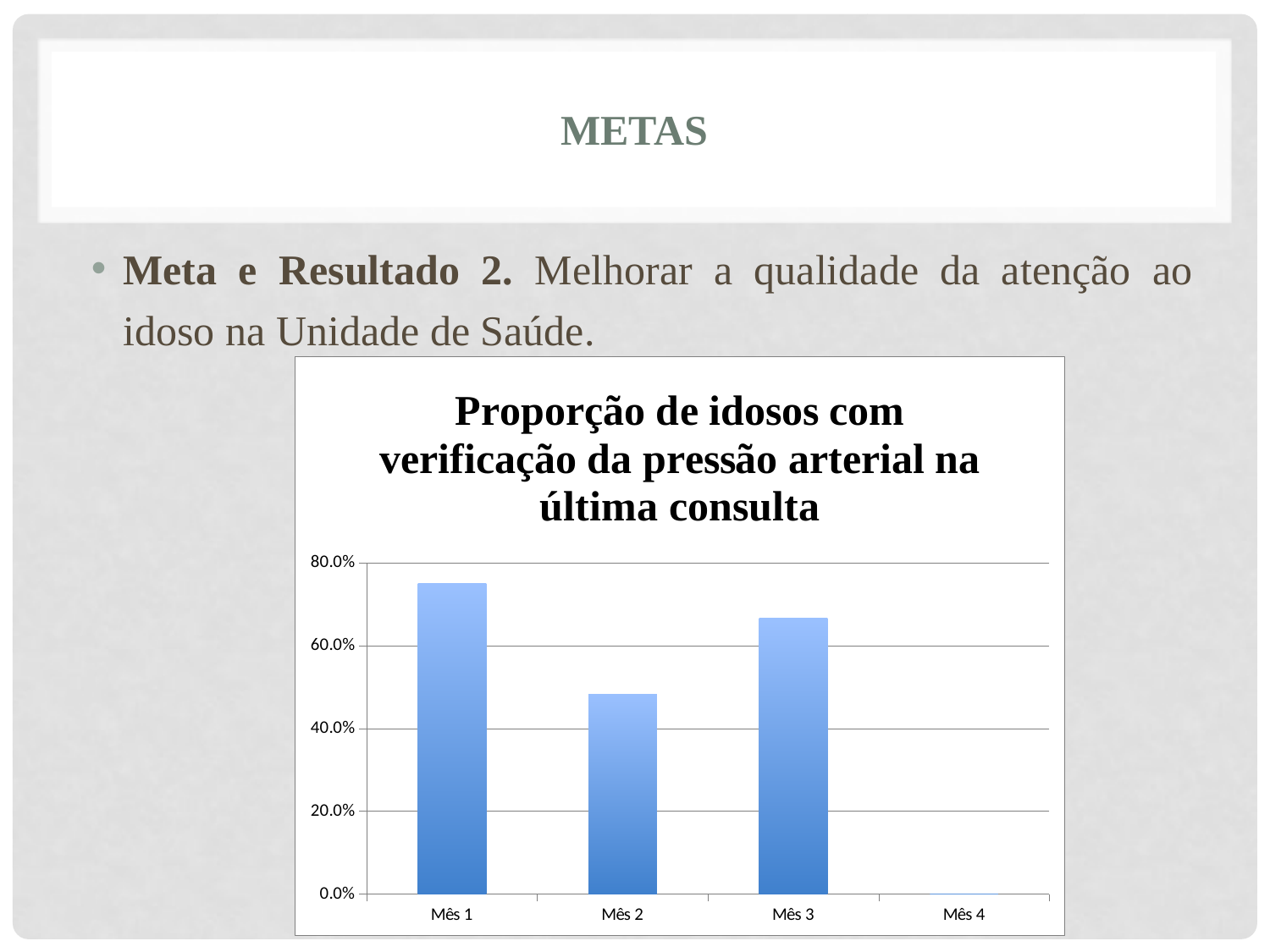
What is the title of the chart? Proporção de idosos com verificação da pressão arterial na última consulta What kind of chart is shown on the slide? bar chart Is the value for Mês 1 greater or less than 60.0%? greater Which month has the lowest proportion in the chart? Mês 4 Does the value fall or rise from Mês 1 to Mês 2? fall Which month has the highest proportion in the chart? Mês 1 Is the value for Mês 2 greater or less than 60.0%? less Is the value for Mês 3 greater or less than 60.0%? greater Which has a larger value, Mês 1 or Mês 3? Mês 1 How many categories (months) are shown on the x axis of the chart? 4 Which has a larger value, Mês 2 or Mês 3? Mês 3